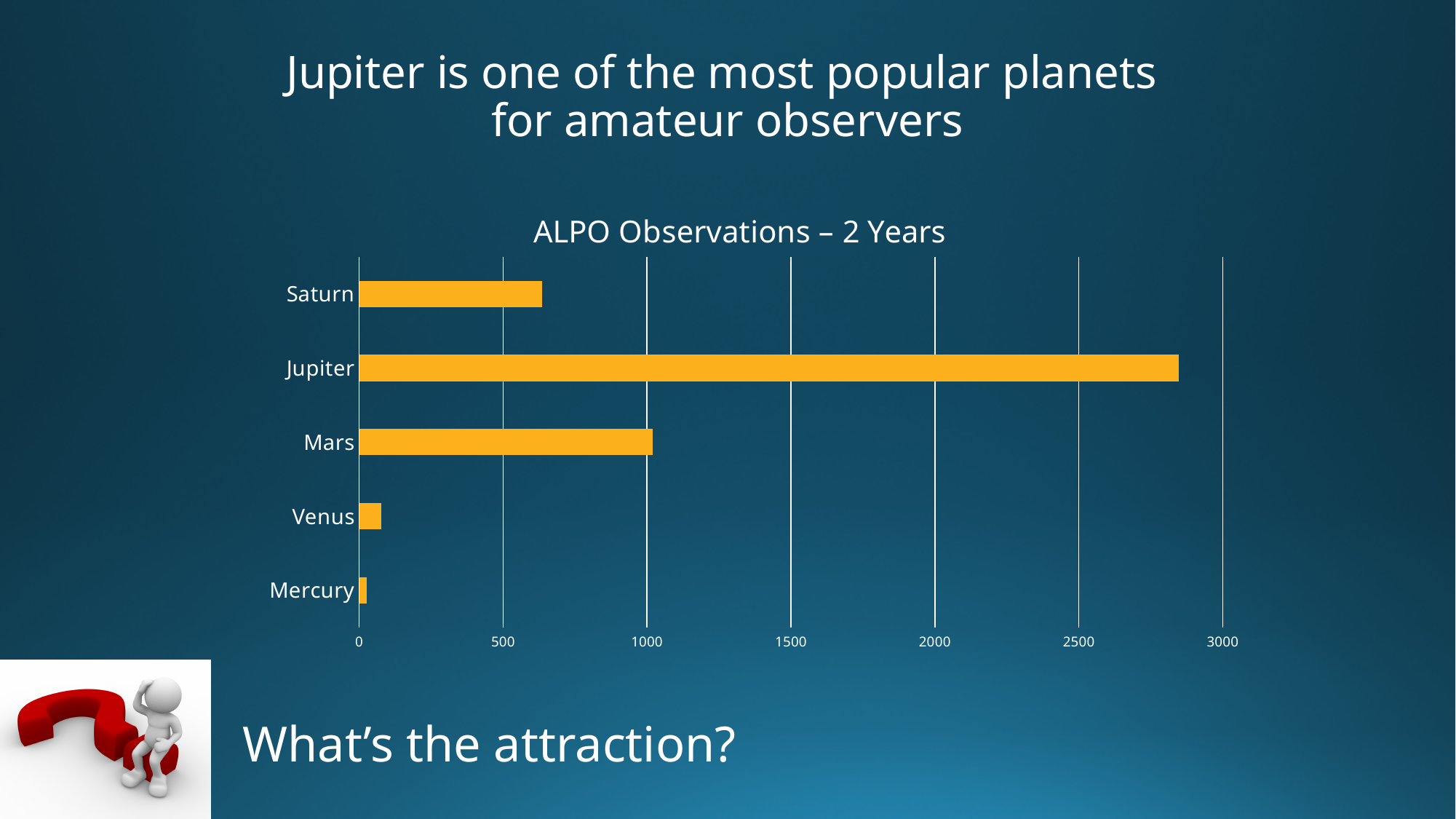
Which planet has the lowest number of observations? Mercury Is the value for Saturn greater or less than 500? greater How many planets are shown in the chart? 5 What is the title of the chart? ALPO Observations – 2 Years Which has more observations, Saturn or Mars? Mars Is the value for Venus greater or less than 500? less What colour are the bars in the chart? orange Is the value for Mars greater or less than 1500? less Which has more observations, Venus or Mercury? Venus What type of chart is shown on the slide? bar chart Which planet has the highest number of observations? Jupiter